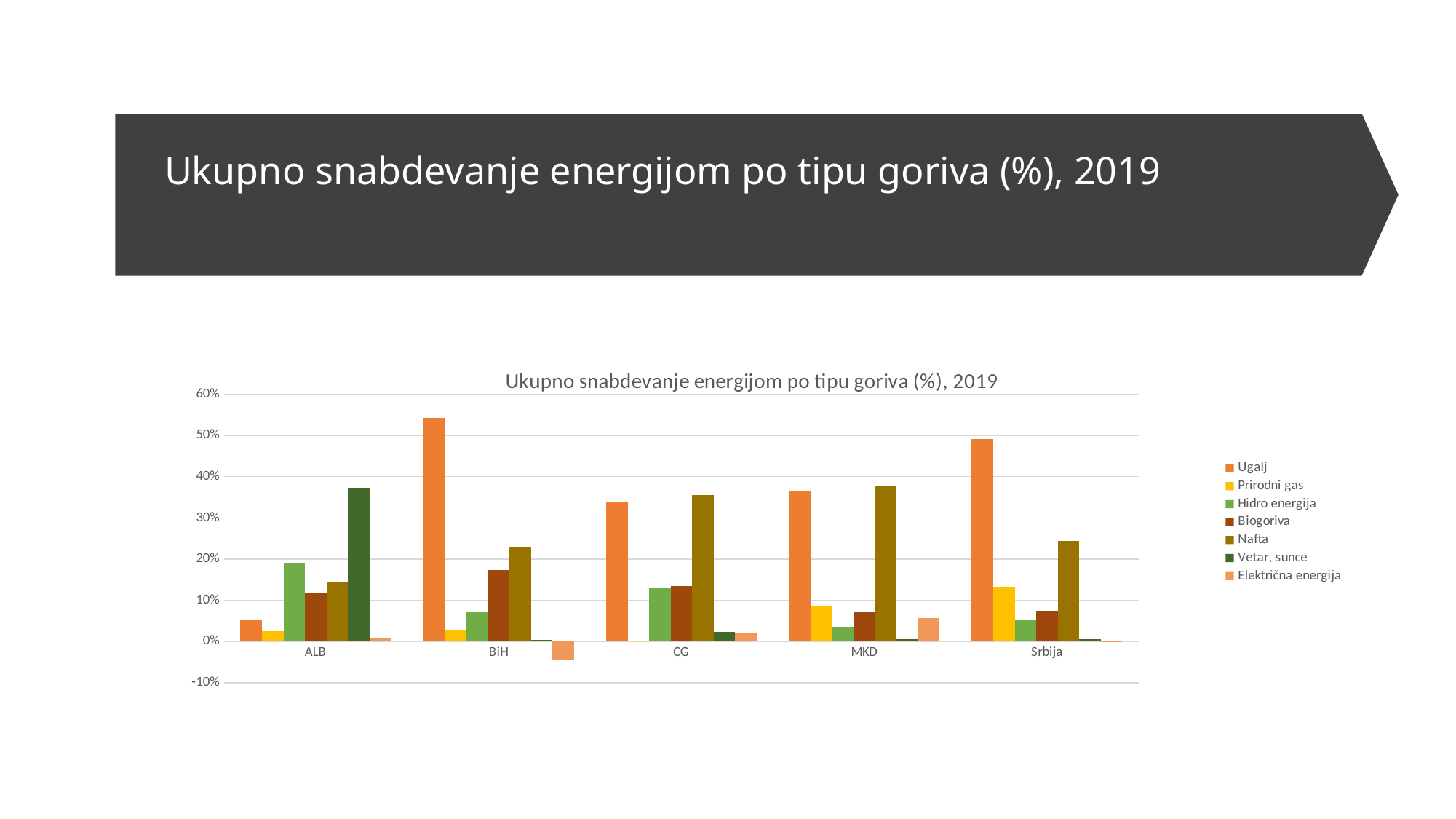
How many series does the chart's legend list? 7 Which is larger, the Hidro energija value for ALB or for BiH? ALB Is the value for Ugalj in BiH greater or less than 50%? greater Which country has the highest value for Ugalj? BiH Is the value for Nafta in Srbija greater or less than 30%? less How many countries (categories) are shown on the x axis of the chart? 5 In Srbija, which is larger, the value for Ugalj or for Nafta? Ugalj Is the value for Električna energija in BiH greater or less than 0%? less What is the title of the chart? Ukupno snabdevanje energijom po tipu goriva (%), 2019 What kind of chart is shown on the slide? bar chart Which country has the lowest value for Ugalj? ALB